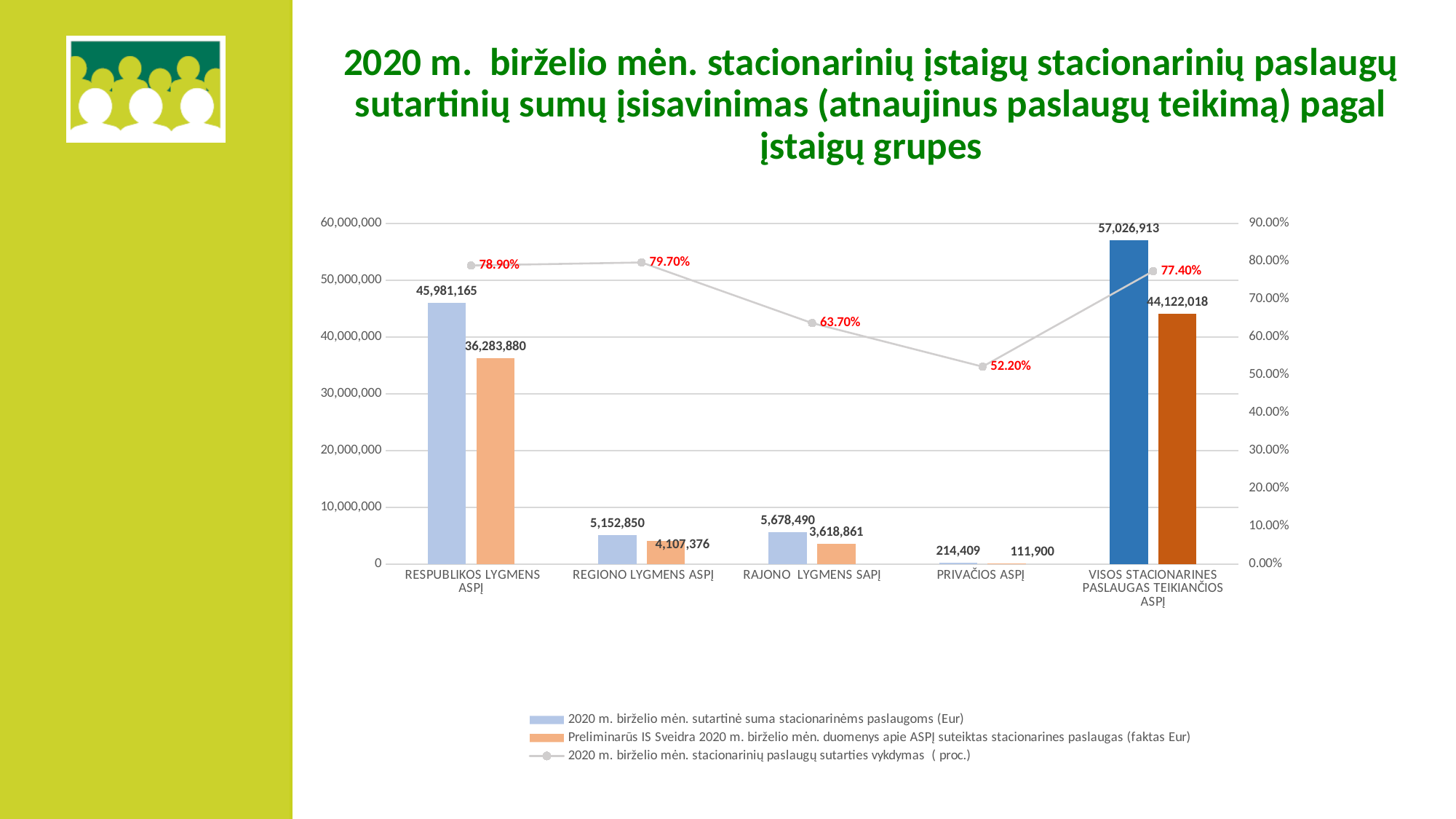
Which category has the highest sutarties vykdymas percentage? REGIONO LYGMENS ASPĮ What is the difference between the sutartinė suma and the faktas value for VISOS STACIONARINES PASLAUGAS TEIKIANČIOS ASPĮ? 12,904,895 What is the sutarties vykdymas percentage for PRIVAČIOS ASPĮ? 52.20% What is the difference between the sutartinė suma and the faktas value for RESPUBLIKOS LYGMENS ASPĮ? 9,697,285 What is the 2020 m. birželio mėn. sutartinė suma (Eur) for RESPUBLIKOS LYGMENS ASPĮ? 45,981,165 Which has the larger sutartinė suma (Eur): REGIONO LYGMENS ASPĮ or RAJONO LYGMENS SAPĮ? RAJONO LYGMENS SAPĮ Is the sutartinė suma for VISOS STACIONARINES PASLAUGAS TEIKIANČIOS ASPĮ greater or less than 50,000,000? greater How many series does the legend list? 3 What is the faktas (Eur) value for RAJONO LYGMENS SAPĮ? 3,618,861 How many categories are shown on the x axis? 5 Which category has the lowest 2020 m. birželio mėn. sutartinė suma (Eur)? PRIVAČIOS ASPĮ What kind of chart is shown on the slide? Combined bar and line chart